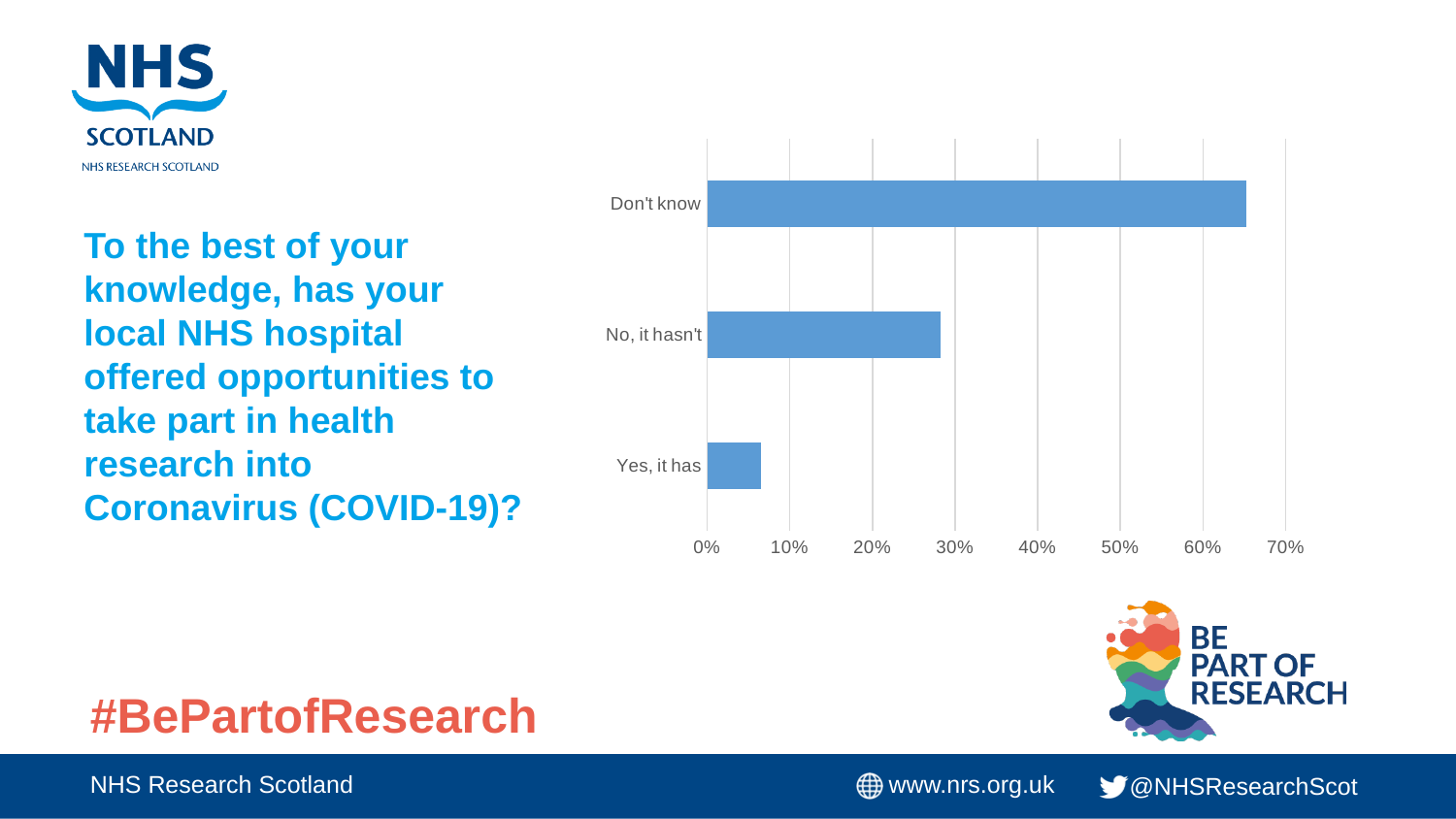
Is the value for "No, it hasn't" greater or less than 30%? less Is the value for "Yes, it has" greater or less than 10%? less How many categories are plotted in the chart? 3 What colour are the bars in the chart? blue Which category has the lowest value? Yes, it has Which category has the highest value? Don't know Which is larger, the value for "No, it hasn't" or the value for "Yes, it has"? No, it hasn't Which is larger, the value for "Don't know" or the value for "No, it hasn't"? Don't know Is the value for "No, it hasn't" greater or less than 20%? greater What kind of chart is shown on the slide? bar chart What is the highest value shown on the chart's horizontal axis? 70%